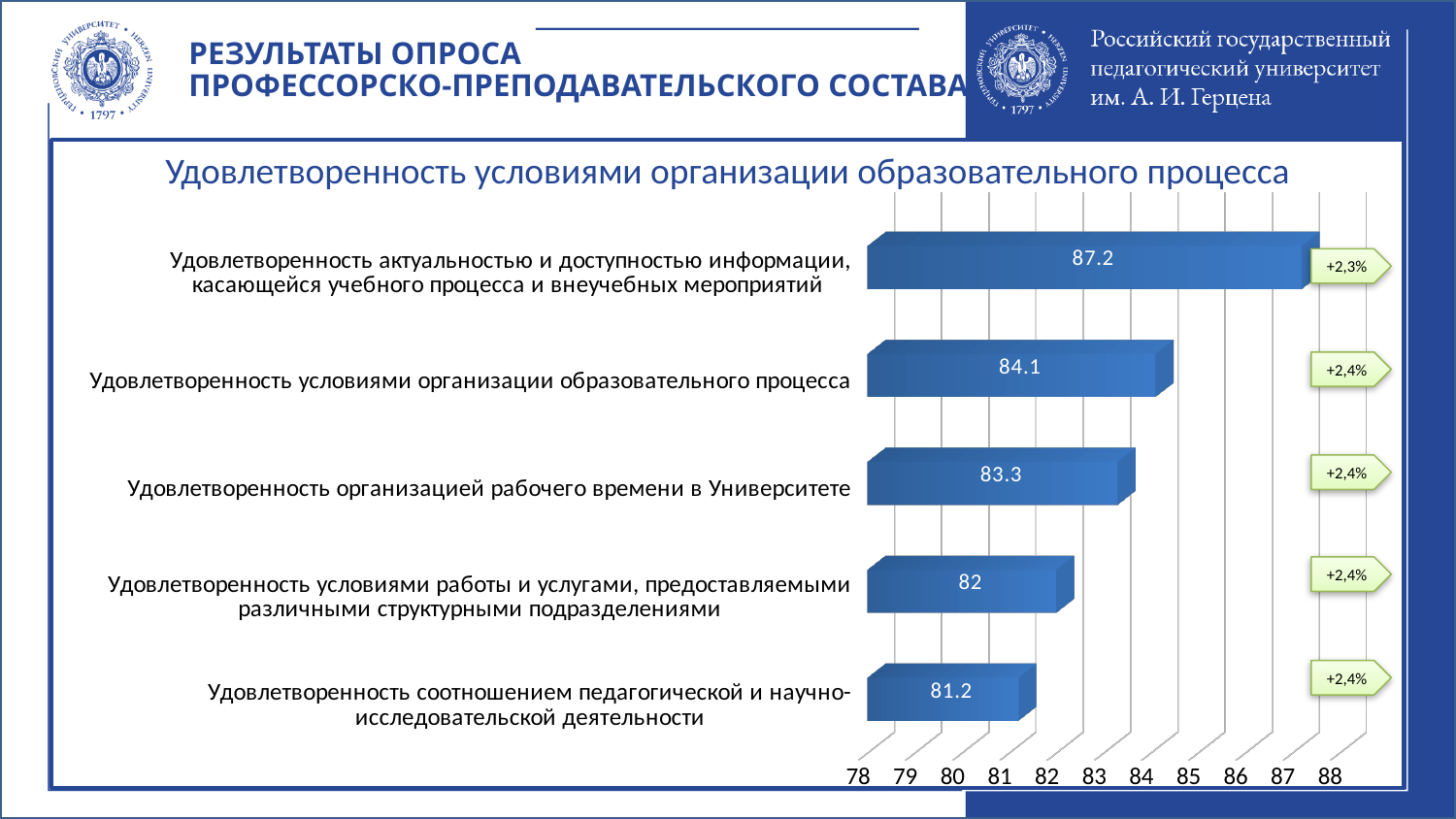
What value is shown for "Удовлетворенность условиями работы и услугами, предоставляемыми различными структурными подразделениями"? 82 What value is shown for "Удовлетворенность актуальностью и доступностью информации, касающейся учебного процесса и внеучебных мероприятий"? 87.2 What is the difference between the value for "Удовлетворенность условиями организации образовательного процесса" and the value for "Удовлетворенность организацией рабочего времени в Университете"? 0.8 How many categories are shown in the chart? 5 What value is shown for "Удовлетворенность организацией рабочего времени в Университете"? 83.3 Is the value for "Удовлетворенность условиями организации образовательного процесса" greater or less than 83? greater Which category has the lowest value? Удовлетворенность соотношением педагогической и научно-исследовательской деятельности Which is larger: the value for "Удовлетворенность условиями работы и услугами, предоставляемыми различными структурными подразделениями" or the value for "Удовлетворенность соотношением педагогической и научно-исследовательской деятельности"? Удовлетворенность условиями работы и услугами, предоставляемыми различными структурными подразделениями What kind of chart is shown on the slide? bar chart Which category has the highest value? Удовлетворенность актуальностью и доступностью информации, касающейся учебного процесса и внеучебных мероприятий What is the title of the chart? Удовлетворенность условиями организации образовательного процесса What value is shown for "Удовлетворенность соотношением педагогической и научно-исследовательской деятельности"? 81.2